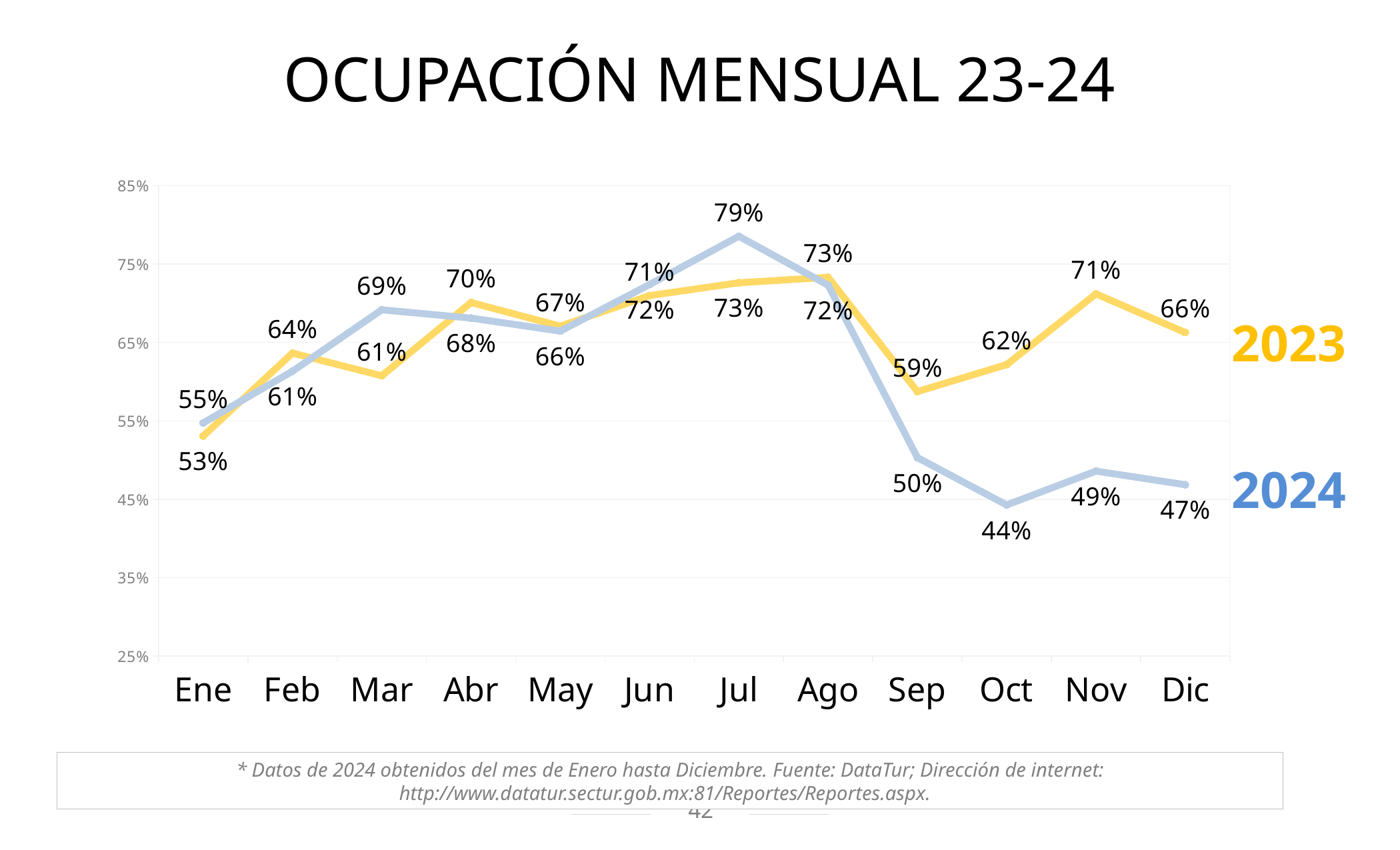
How many series does the chart show? 2 What is the 2024 occupancy value for Jul? 79% What is the 2023 occupancy value for Nov? 71% Which month has the lowest 2024 value? Oct What type of chart is shown on the slide? line chart What is the 2024 occupancy value for Oct? 44% Which month has the lowest 2023 value? Ene Which series has the larger value in Mar, 2023 or 2024? 2024 What is the 2023 occupancy value for Ene? 53% How many months are plotted on the x axis? 12 What is the difference between the 2023 and 2024 values for Oct? 18% Which month has the highest 2024 value? Jul